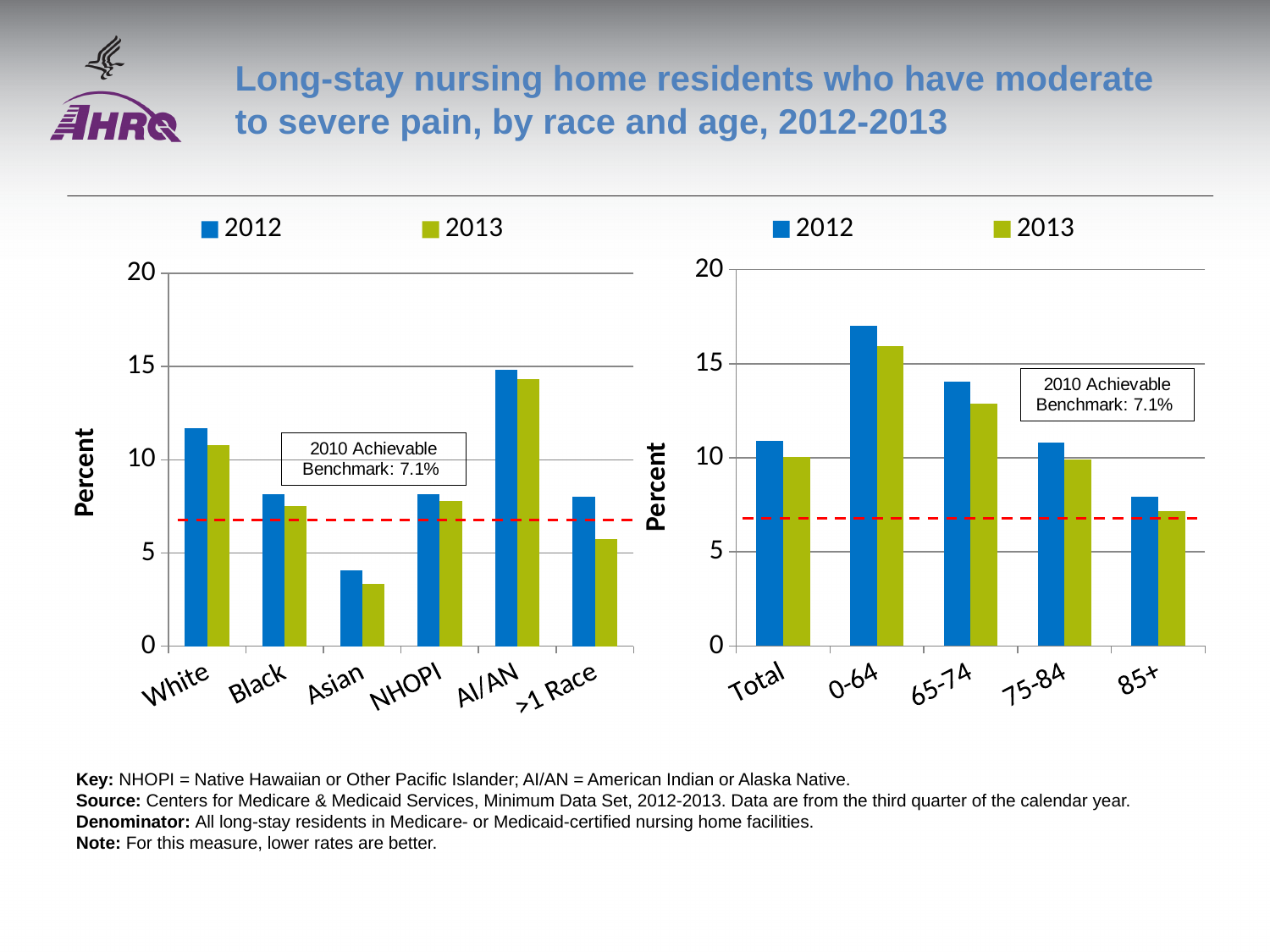
In the right chart (by age), how many series does the legend list? 2 In the left chart (by race), how many race categories are shown on the x axis? 6 In the left chart (by race), which race category has the lowest value for 2013? Asian In the left chart (by race), which race category has the highest value for 2012? AI/AN In the right chart (by age), is the 2012 value for 0-64 greater or less than 15? greater In the right chart (by age), which age group has the highest value for 2012? 0-64 In the right chart (by age), which age group has the lowest value for 2013? 85+ What kind of chart is the left chart (by race)? bar chart What is the 2010 Achievable Benchmark shown on the charts? 7.1% In the right chart (by age), which is larger for 2013: the value for 65-74 or the value for 75-84? 65-74 In the left chart (by race), is the 2012 value for White greater or less than 10? greater In the left chart (by race), is the 2013 value for Asian greater or less than 5? less